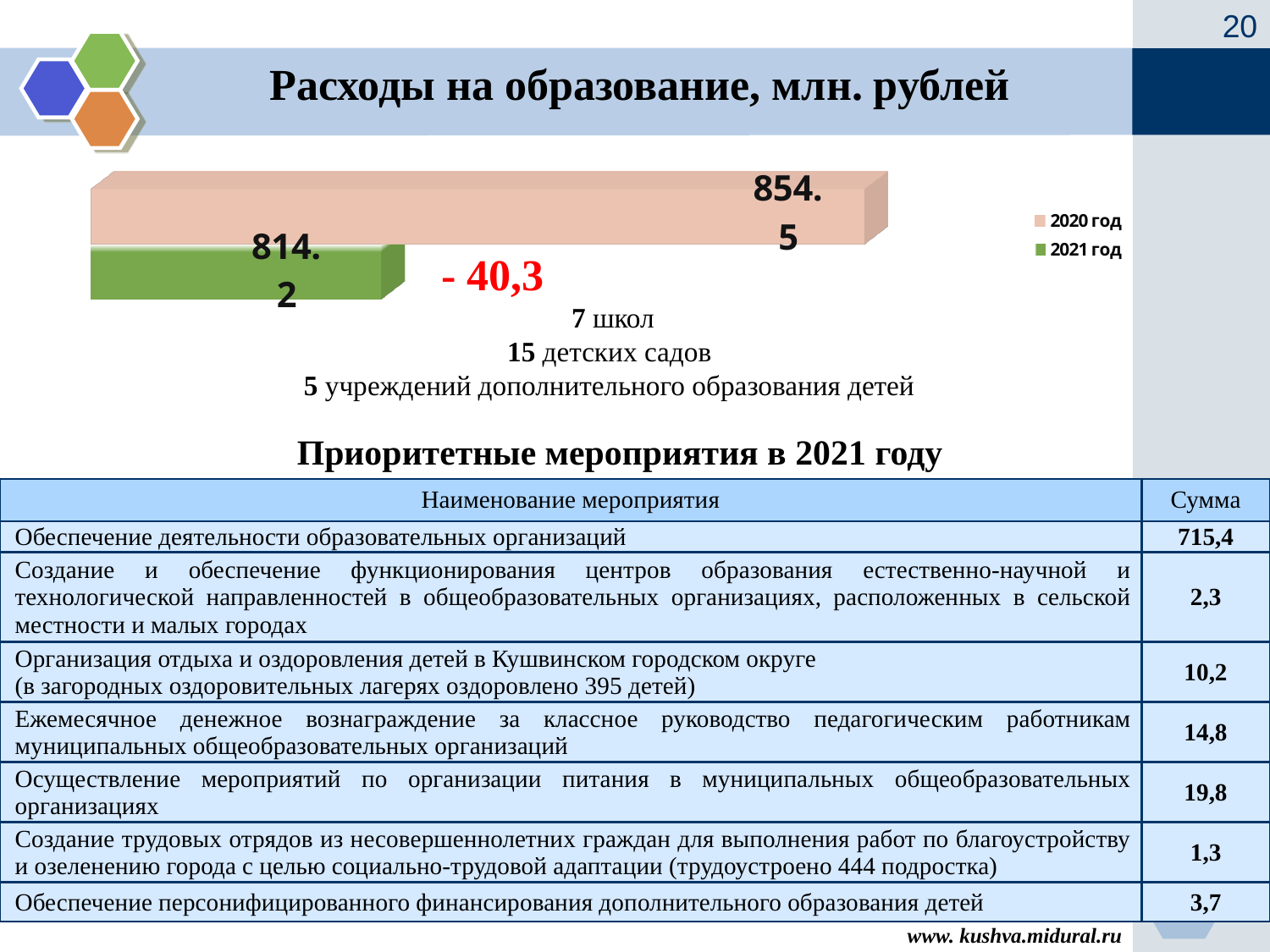
Which year has the higher value in the chart, 2020 год or 2021 год? 2020 год How many bars are plotted in the chart? 2 Which series has the lowest value in the chart? 2021 год What is the value for 2021 год in the chart? 814.2 What is the difference between the 2020 год and 2021 год values in the chart? 40,3 What is the value for 2020 год in the chart? 854.5 Did the value fall or rise from 2020 год to 2021 год? fall How many series does the chart legend list? 2 What colour is the bar for 2021 год in the chart? green What kind of chart is shown on the slide? bar chart Which series has the highest value in the chart? 2020 год What is the title of the chart? Расходы на образование, млн. рублей